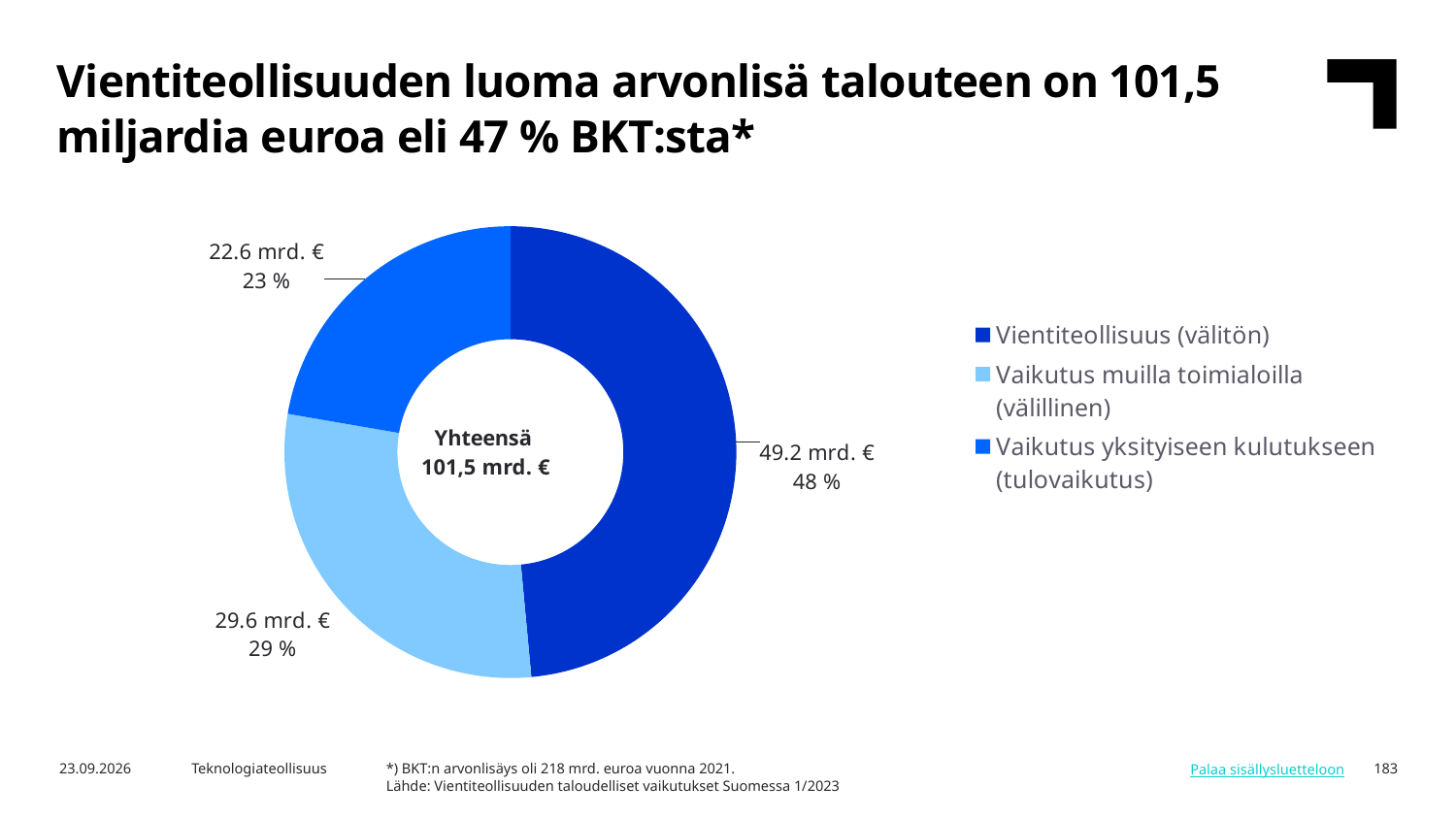
What is the value for Vaikutus yksityiseen kulutukseen (tulovaikutus)? 22.6 mrd. € What is the value for Vientiteollisuus (välitön)? 49.2 mrd. € What is the difference in mrd. € between Vientiteollisuus (välitön) and Vaikutus muilla toimialoilla (välillinen)? 19.6 mrd. € Which category has the smallest slice? Vaikutus yksityiseen kulutukseen (tulovaikutus) What share of the pie does Vaikutus yksityiseen kulutukseen (tulovaikutus) represent? 23 % What kind of chart is shown on the slide? Pie chart (donut) What is the value for Vaikutus muilla toimialoilla (välillinen)? 29.6 mrd. € Which category has the largest slice? Vientiteollisuus (välitön) What share of the pie does Vientiteollisuus (välitön) represent? 48 % Which is larger, Vaikutus muilla toimialoilla (välillinen) or Vaikutus yksityiseen kulutukseen (tulovaikutus)? Vaikutus muilla toimialoilla (välillinen) How many categories does the legend list? 3 What total is printed in the centre of the donut chart? Yhteensä 101,5 mrd. €